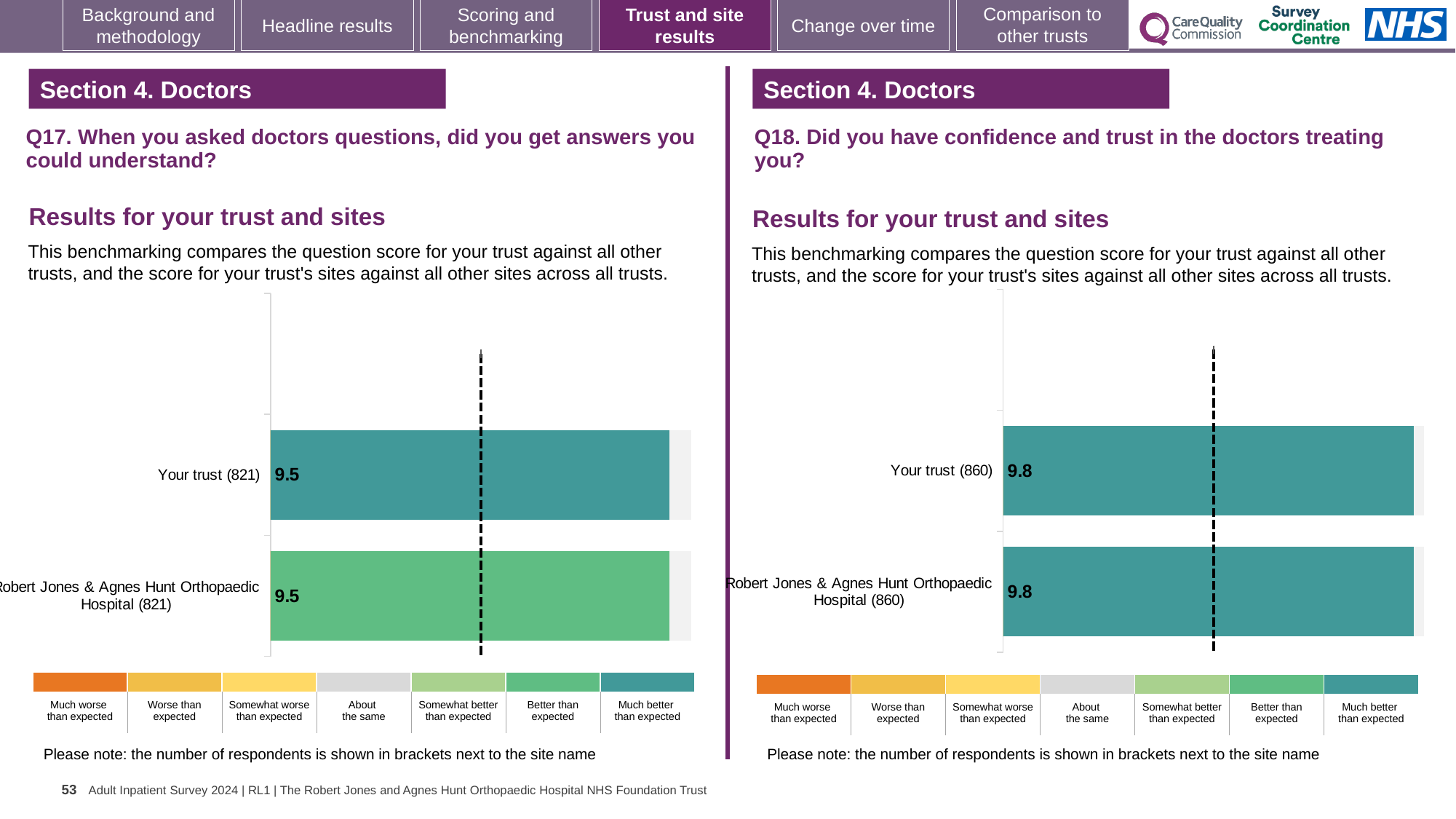
On the Q18 chart (right), how many respondents are shown in brackets for Robert Jones & Agnes Hunt Orthopaedic Hospital? 860 What kind of chart is used on the Q17 chart (left)? Bar chart On the Q17 chart (left), what is the score for Robert Jones & Agnes Hunt Orthopaedic Hospital? 9.5 On the Q18 chart (right), what is the score for Robert Jones & Agnes Hunt Orthopaedic Hospital? 9.8 On the Q17 chart (left), what is the score for Your trust? 9.5 On the Q17 chart (left), how many respondents are shown in brackets for Your trust? 821 How many bars are plotted on the Q18 chart (right)? 2 On the Q18 chart (right), what is the score for Your trust? 9.8 On the Q18 chart (right), what is the difference between the score for Your trust and the score for Robert Jones & Agnes Hunt Orthopaedic Hospital? 0 On the Q17 chart (left), what is the difference between the score for Your trust and the score for Robert Jones & Agnes Hunt Orthopaedic Hospital? 0 How many bars are plotted on the Q17 chart (left)? 2